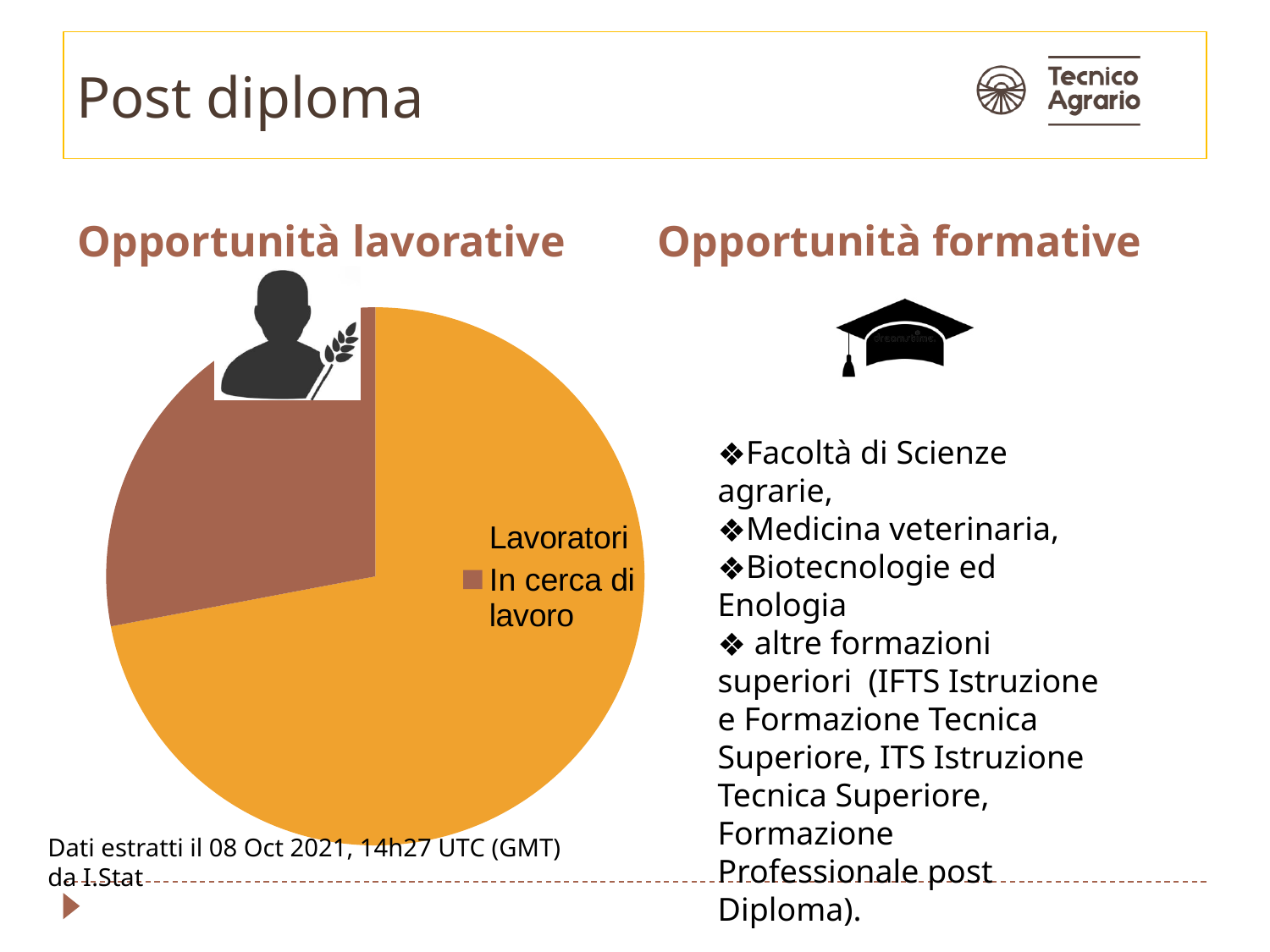
In the pie chart, which is larger: Lavoratori or In cerca di lavoro? Lavoratori What kind of chart is shown under "Opportunità lavorative"? pie chart How many entries does the pie chart's legend list? 2 Which slice of the pie chart is the largest? Lavoratori What colour is the "In cerca di lavoro" slice in the pie chart? brown Which slice of the pie chart is the smallest? In cerca di lavoro What are the two legend entries of the pie chart? Lavoratori; In cerca di lavoro How many slices does the pie chart have? 2